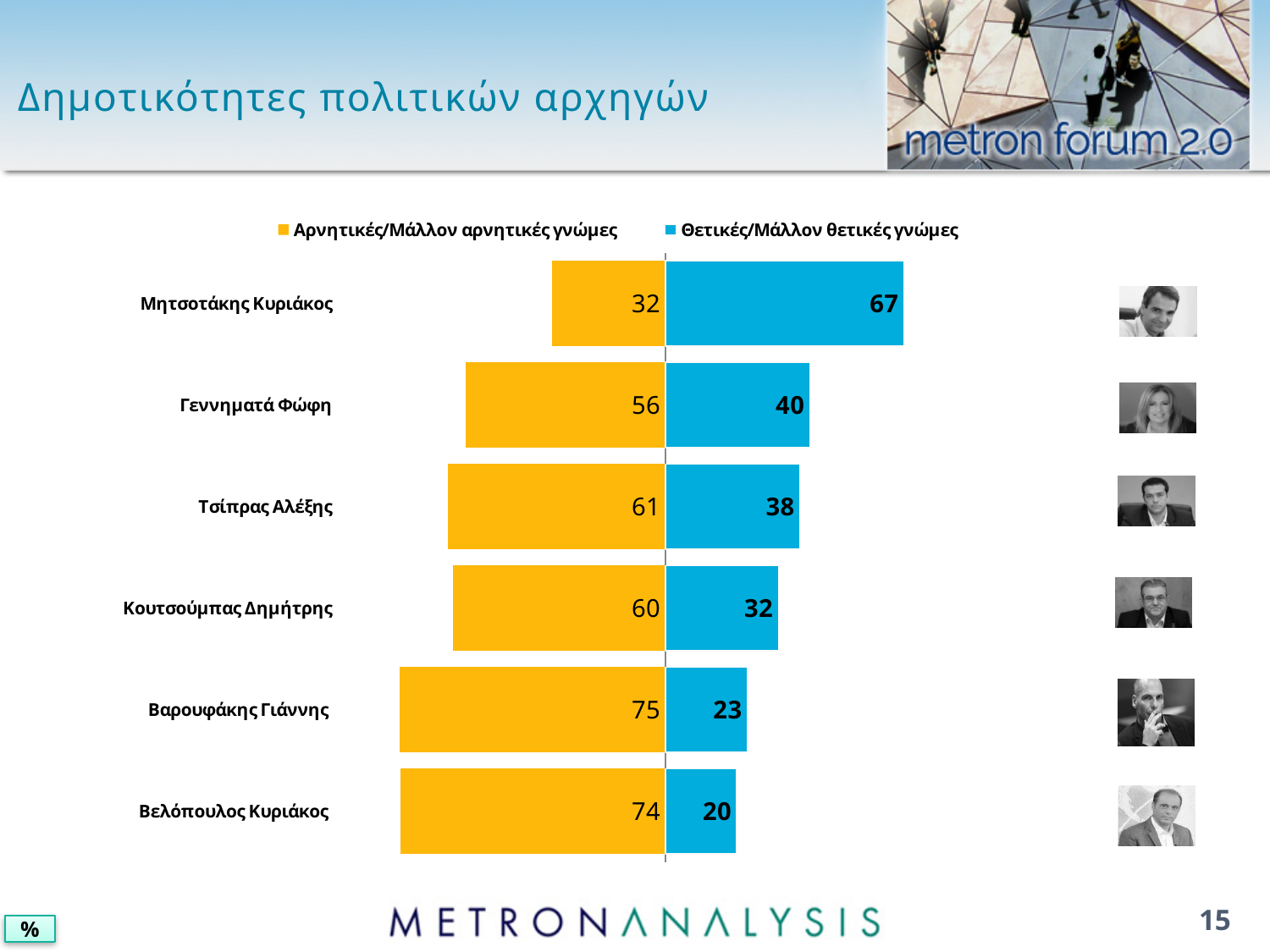
What is the value of Αρνητικές/Μάλλον αρνητικές γνώμες for Βαρουφάκης Γιάννης? 75 What kind of chart is shown on the slide? Bar chart What is the value of Θετικές/Μάλλον θετικές γνώμες for Μητσοτάκης Κυριάκος? 67 What is the difference between the Αρνητικές/Μάλλον αρνητικές γνώμες values for Τσίπρας Αλέξης and Γεννηματά Φώφη? 5 What is the value of Θετικές/Μάλλον θετικές γνώμες for Βελόπουλος Κυριάκος? 20 Which politician has the highest value for Θετικές/Μάλλον θετικές γνώμες? Μητσοτάκης Κυριάκος What is the total of the two values shown for Βαρουφάκης Γιάννης? 98 Which is larger: the Θετικές/Μάλλον θετικές γνώμες value for Γεννηματά Φώφη or for Κουτσούμπας Δημήτρης? Γεννηματά Φώφη What colour represents Θετικές/Μάλλον θετικές γνώμες in the chart? Blue Which politician has the lowest value for Αρνητικές/Μάλλον αρνητικές γνώμες? Μητσοτάκης Κυριάκος How many series does the legend list? 2 How many politicians are shown in the chart? 6